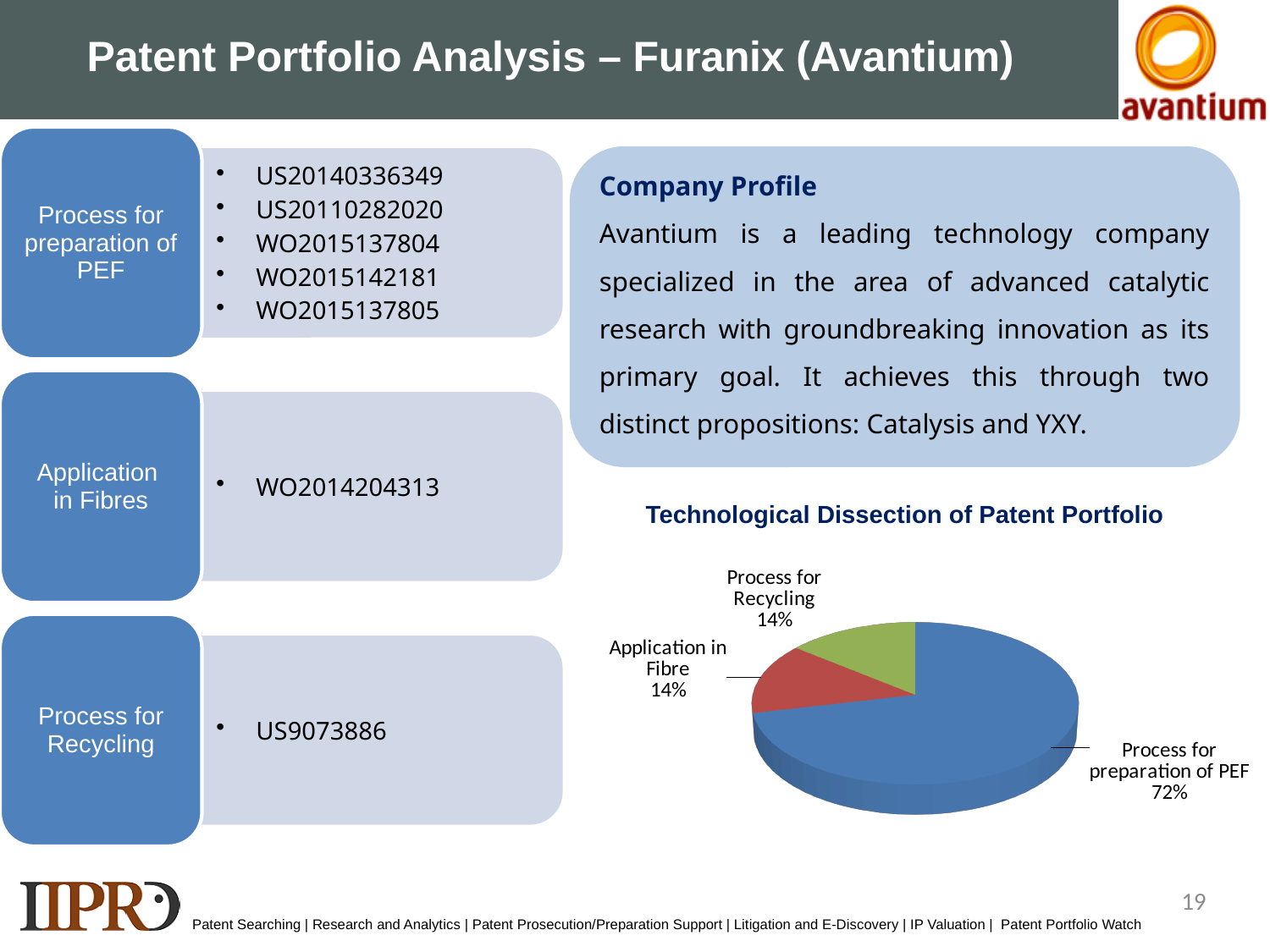
What share of the patent portfolio does "Process for preparation of PEF" represent in the pie chart? 72% What is the combined share of "Application in Fibre" and "Process for Recycling" in the pie chart? 28% What percentage is shown for "Process for Recycling" in the pie chart? 14% How many slices does the pie chart have? 3 What colour is the "Process for preparation of PEF" slice in the pie chart? blue What is the difference in percentage points between "Process for preparation of PEF" and "Process for Recycling" in the pie chart? 58% What percentage is shown for "Application in Fibre" in the pie chart? 14% What is the title of the pie chart on the slide? Technological Dissection of Patent Portfolio Which category has the largest slice in the pie chart? Process for preparation of PEF Which is larger in the pie chart: "Process for preparation of PEF" or "Application in Fibre"? Process for preparation of PEF What kind of chart is shown under the title "Technological Dissection of Patent Portfolio"? pie chart